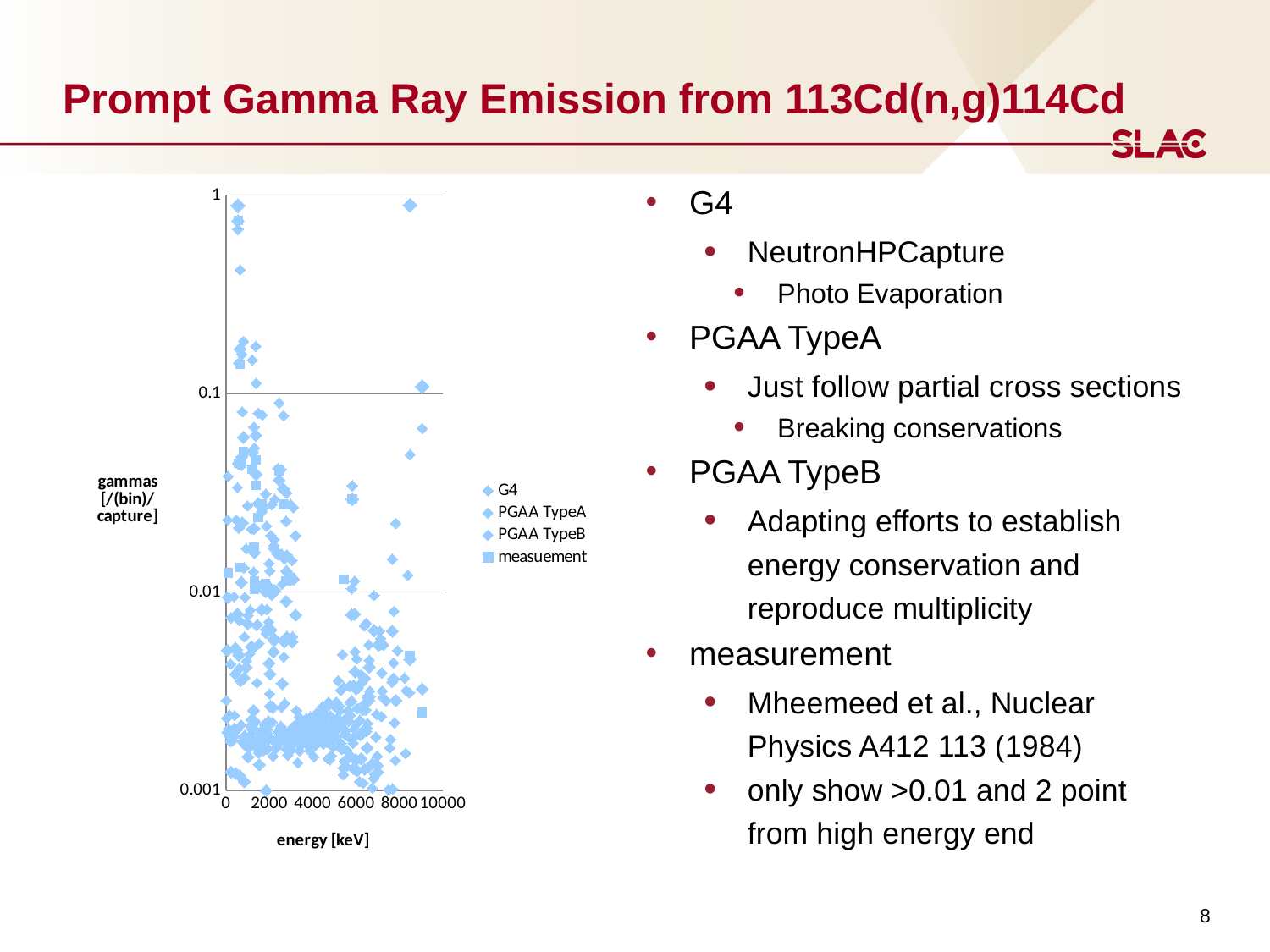
What kind of chart is shown on the slide? scatter chart What is the highest tick value shown on the x axis of the chart? 10000 What is the lowest tick value shown on the y axis of the chart? 0.001 What is the label of the x axis of the chart? energy [keV] Are the points near 4000 keV mostly greater or less than 0.01? less How many series does the chart legend list? 4 Is the highest plotted point on the chart greater or less than 0.1? greater What are the four series listed in the chart legend? G4, PGAA TypeA, PGAA TypeB, measuement